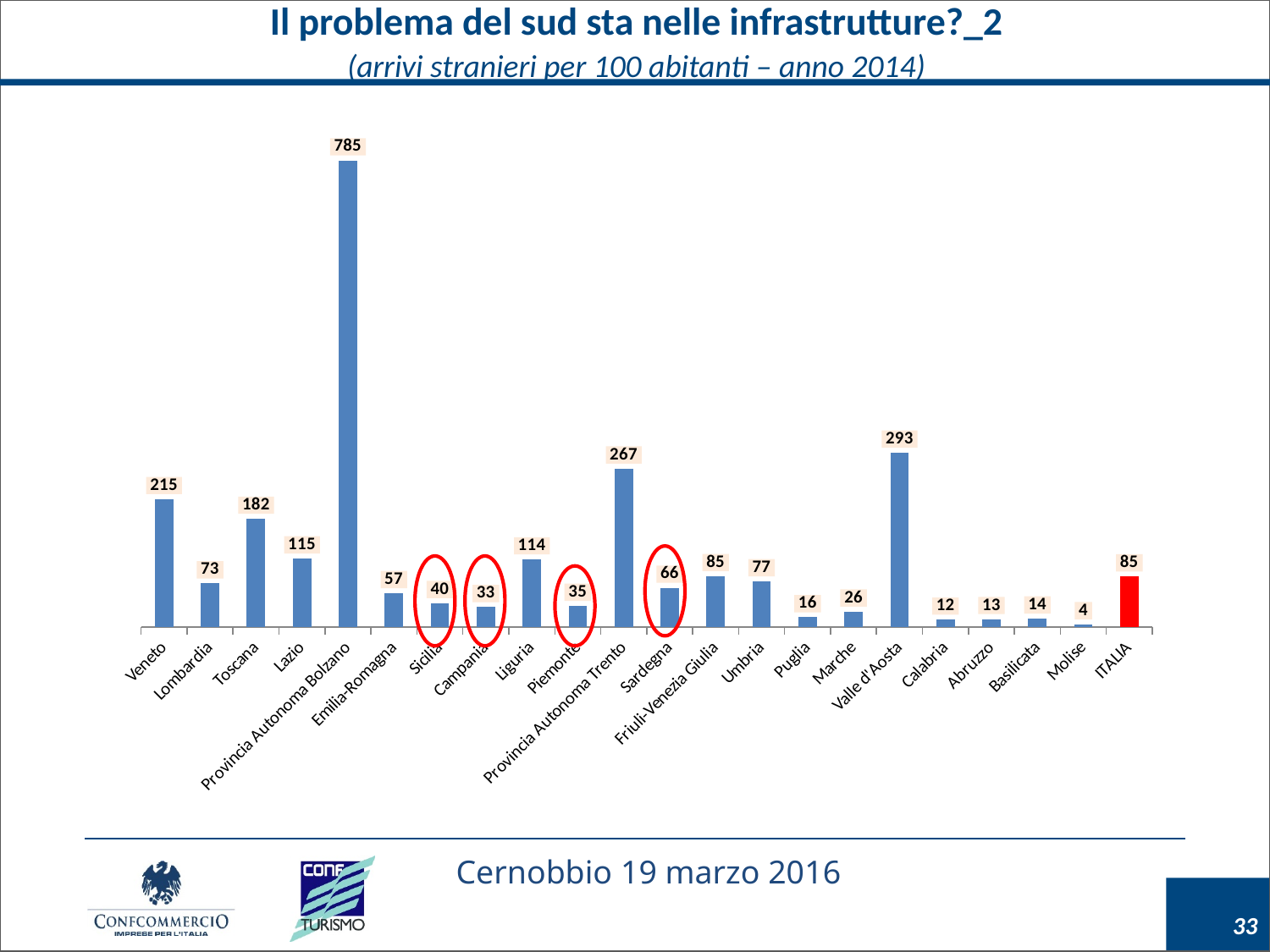
Which category has the highest value? Provincia Autonoma Bolzano What is the difference between the values for Valle d'Aosta and Provincia Autonoma Trento? 26 Which has a larger value, Sicilia or Campania? Sicilia What is the value for Campania? 33 What is the value for Provincia Autonoma Bolzano? 785 Which bar is coloured red instead of blue? ITALIA How many categories are shown on the x axis? 22 Which category has the lowest value? Molise What is the value for Veneto? 215 What is the value for ITALIA? 85 What is the difference between the values for Veneto and Lombardia? 142 What kind of chart is shown on the slide? Bar chart